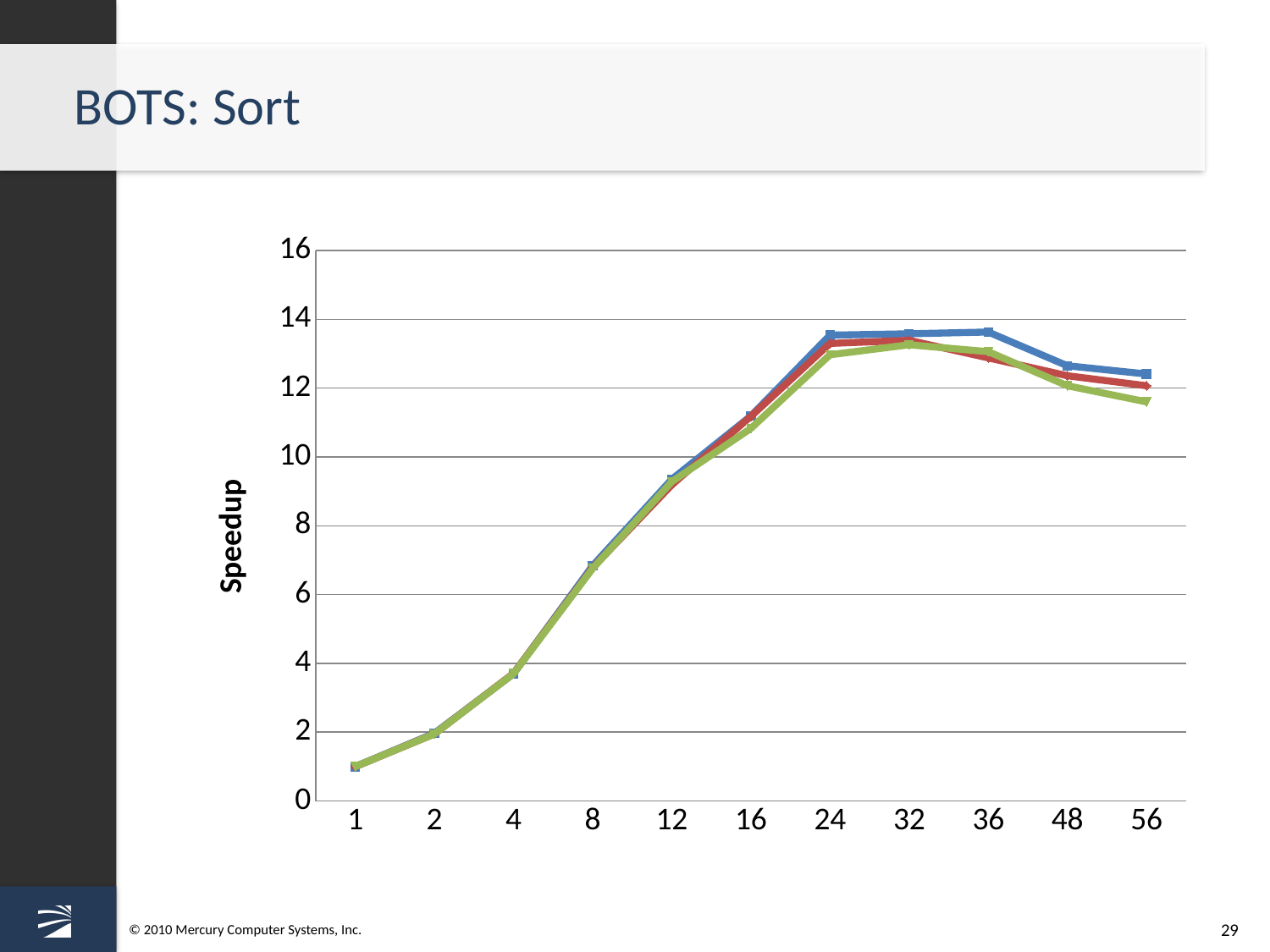
Is the speedup at x = 1 greater or less than 2? less Do the speedup values rise or fall along the x axis from 1 to 24? rise At x = 56, which line has the larger speedup, the blue line or the green line? blue line Is the speedup at x = 16 greater or less than 10? greater At which x-axis category is the speedup lowest? 1 Is the speedup of the blue line at x = 24 greater or less than 12? greater What is the label of the y axis of the chart? Speedup How many categories are shown on the x axis of the chart? 11 What is the title of the slide containing the chart? BOTS: Sort What kind of chart is shown on the slide? line chart